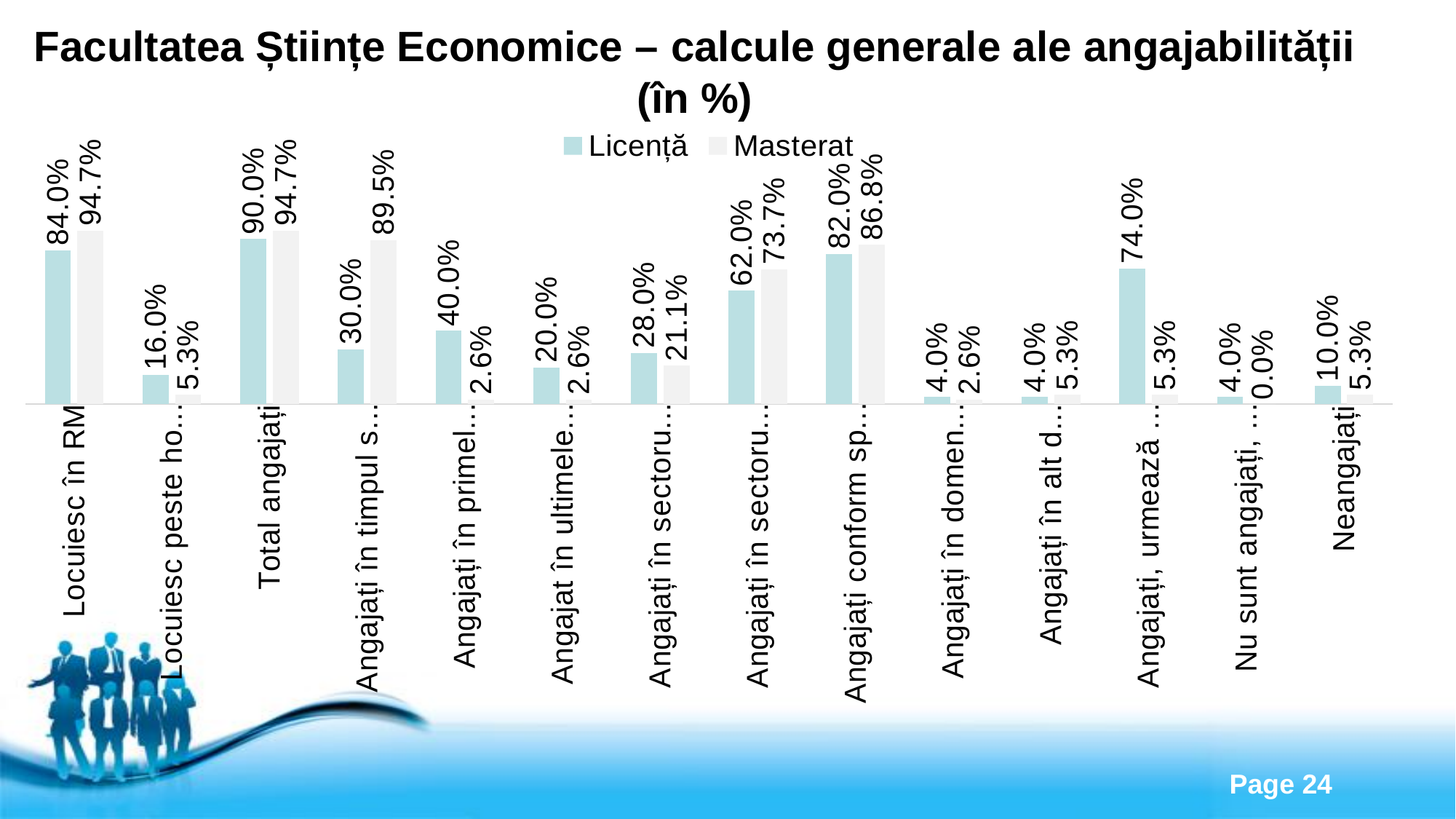
What is the difference between the Masterat and Licență values for "Total angajați"? 4.7 percentage points What is the Masterat value for "Locuiesc în RM"? 94.7% What are the two series named in the legend? Licență and Masterat What is the Licență value for "Locuiesc în RM"? 84.0% What is the Masterat value for "Neangajați"? 5.3% How many series does the legend list? 2 How many categories are plotted on the x axis? 14 What is the Licență value for "Total angajați"? 90.0% For "Neangajați", which series has the larger value, Licență or Masterat? Licență What is the difference between the Masterat and Licență values for "Locuiesc în RM"? 10.7 percentage points What type of chart is shown on the slide? Bar chart Which category has the highest Licență value? Total angajați